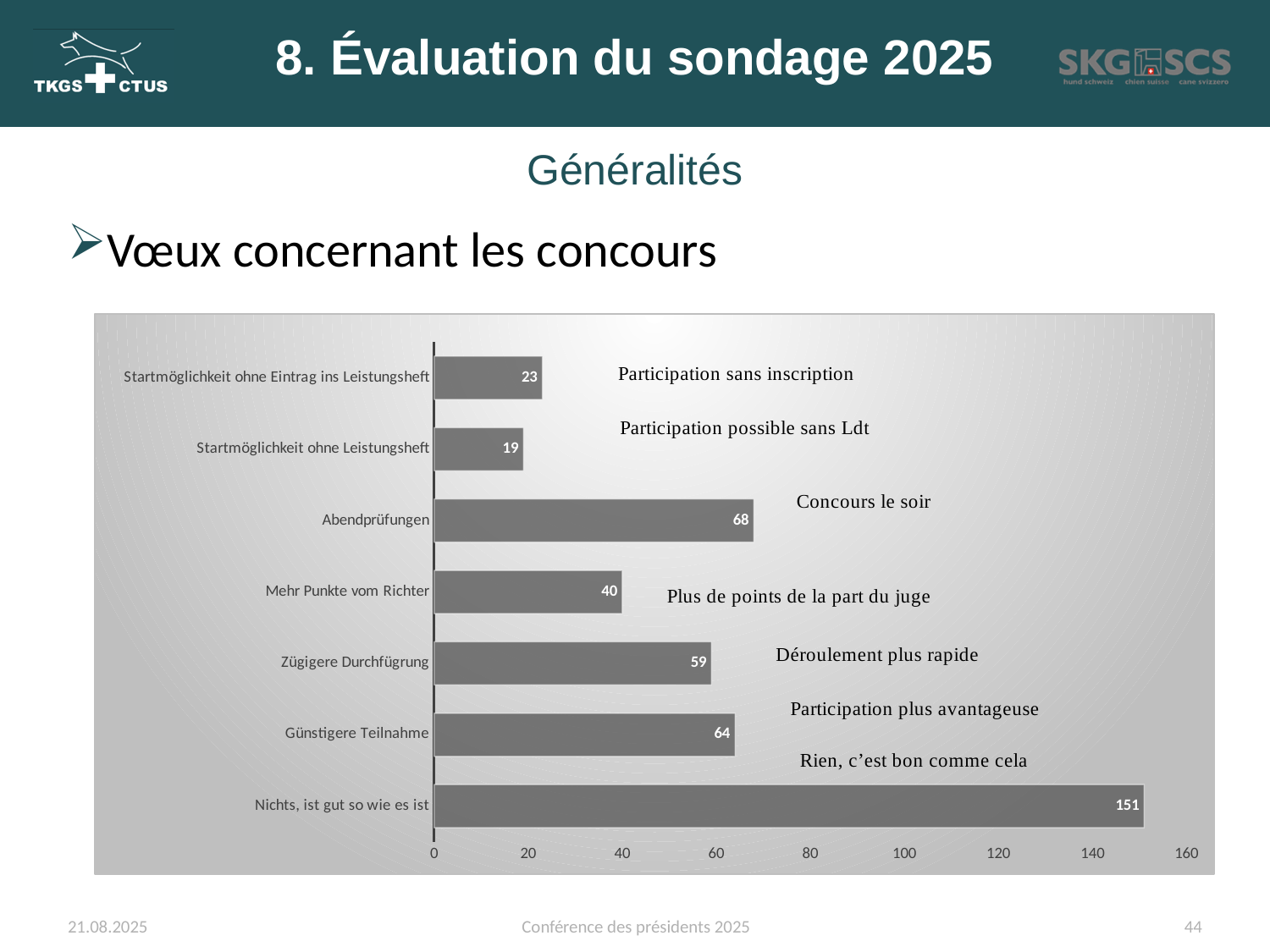
What kind of chart is shown on the slide? bar chart Which category has the lowest value? Startmöglichkeit ohne Leistungsheft What is the value for "Mehr Punkte vom Richter"? 40 What is the maximum value shown on the horizontal axis? 160 How many categories are shown in the chart? 7 Is the value for "Nichts, ist gut so wie es ist" greater or less than 140? greater What is the difference between the values for "Günstigere Teilnahme" and "Zügigere Durchfügrung"? 5 Which category has the highest value? Nichts, ist gut so wie es ist Which is larger, the value for "Abendprüfungen" or the value for "Günstigere Teilnahme"? Abendprüfungen What is the value for "Startmöglichkeit ohne Leistungsheft"? 19 What is the value for "Abendprüfungen"? 68 What is the value for "Nichts, ist gut so wie es ist"? 151